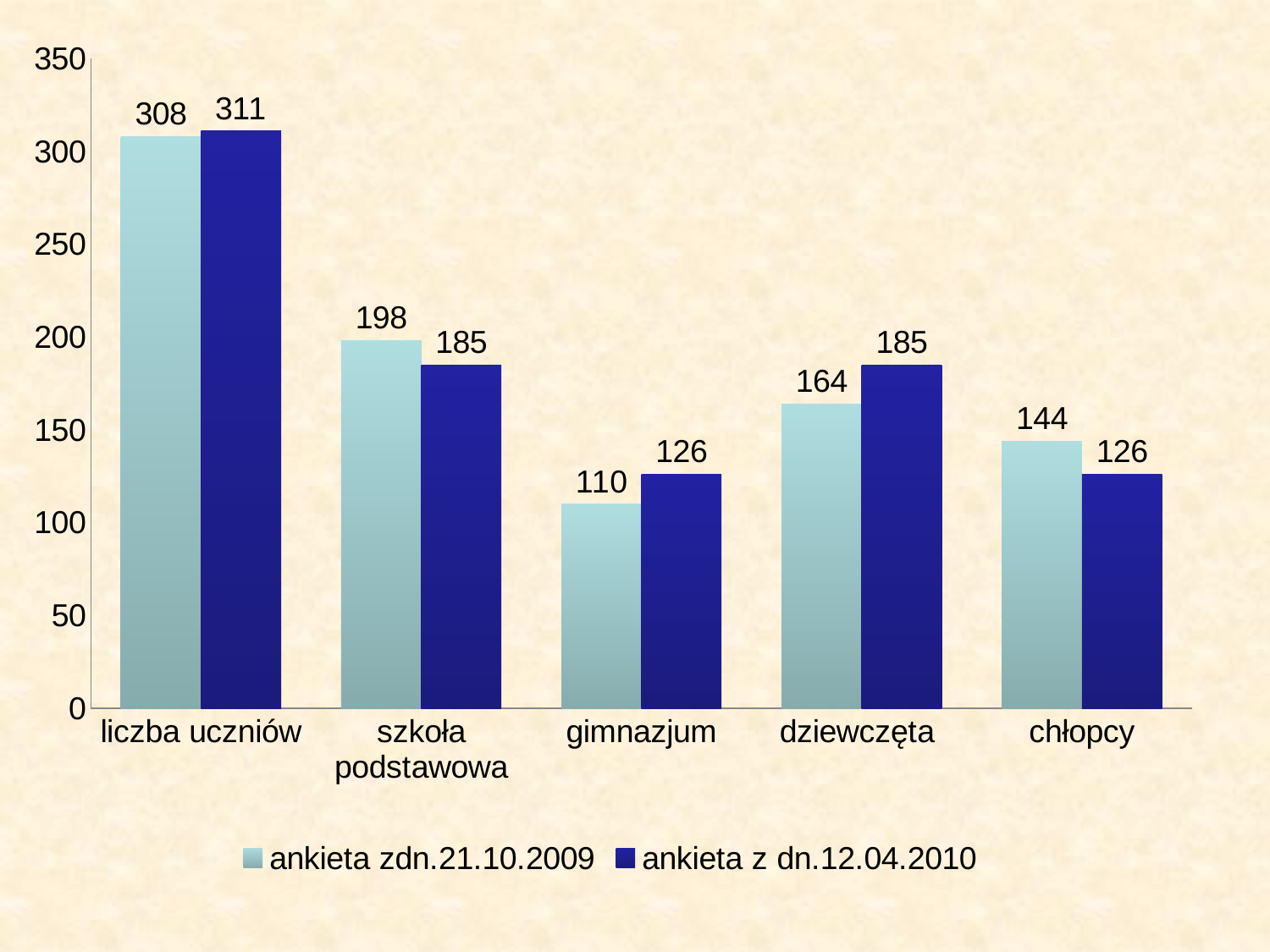
How many categories are shown on the x axis? 5 What is the value for 'dziewczęta' in the 'ankieta zdn.21.10.2009' series? 164 What is the difference between the two series' values for 'szkoła podstawowa'? 13 Which category has the lowest value in the 'ankieta zdn.21.10.2009' series? gimnazjum What is the value for 'liczba uczniów' in the 'ankieta zdn.21.10.2009' series? 308 What is the difference between the two series' values for 'dziewczęta'? 21 What is the value for 'gimnazjum' in the 'ankieta z dn.12.04.2010' series? 126 How many series does the legend list? 2 Is the value for 'gimnazjum' in the 'ankieta zdn.21.10.2009' series greater or less than 150? less What kind of chart is shown on the slide? bar chart Which category has the highest value in the 'ankieta z dn.12.04.2010' series? liczba uczniów For 'chłopcy', which series has the larger value? ankieta zdn.21.10.2009